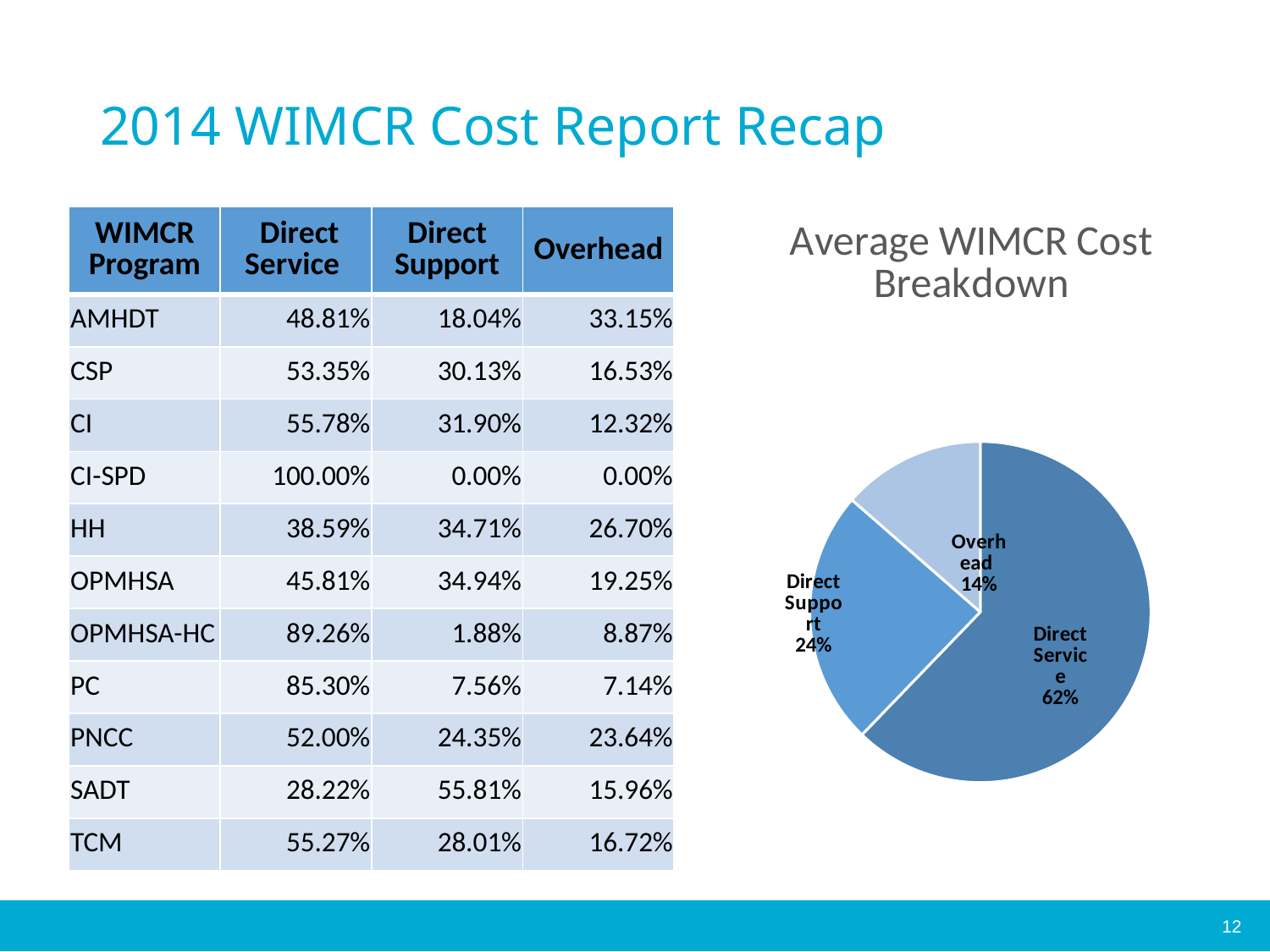
What share of the pie does Direct Service represent? 62% What is the difference in percentage points between the Direct Service and Direct Support slices? 38 What kind of chart is shown on the slide? Pie chart What is the difference in percentage points between the Direct Support and Overhead slices? 10 How many slices does the pie chart have? 3 Which slice of the pie is the smallest? Overhead Which slice of the pie is the largest? Direct Service Which is larger in the pie chart, Direct Support or Overhead? Direct Support What share of the pie does Direct Support represent? 24% Is the Direct Service slice greater or less than 50% of the pie? greater What is the title of the chart? Average WIMCR Cost Breakdown What share of the pie does Overhead represent? 14%